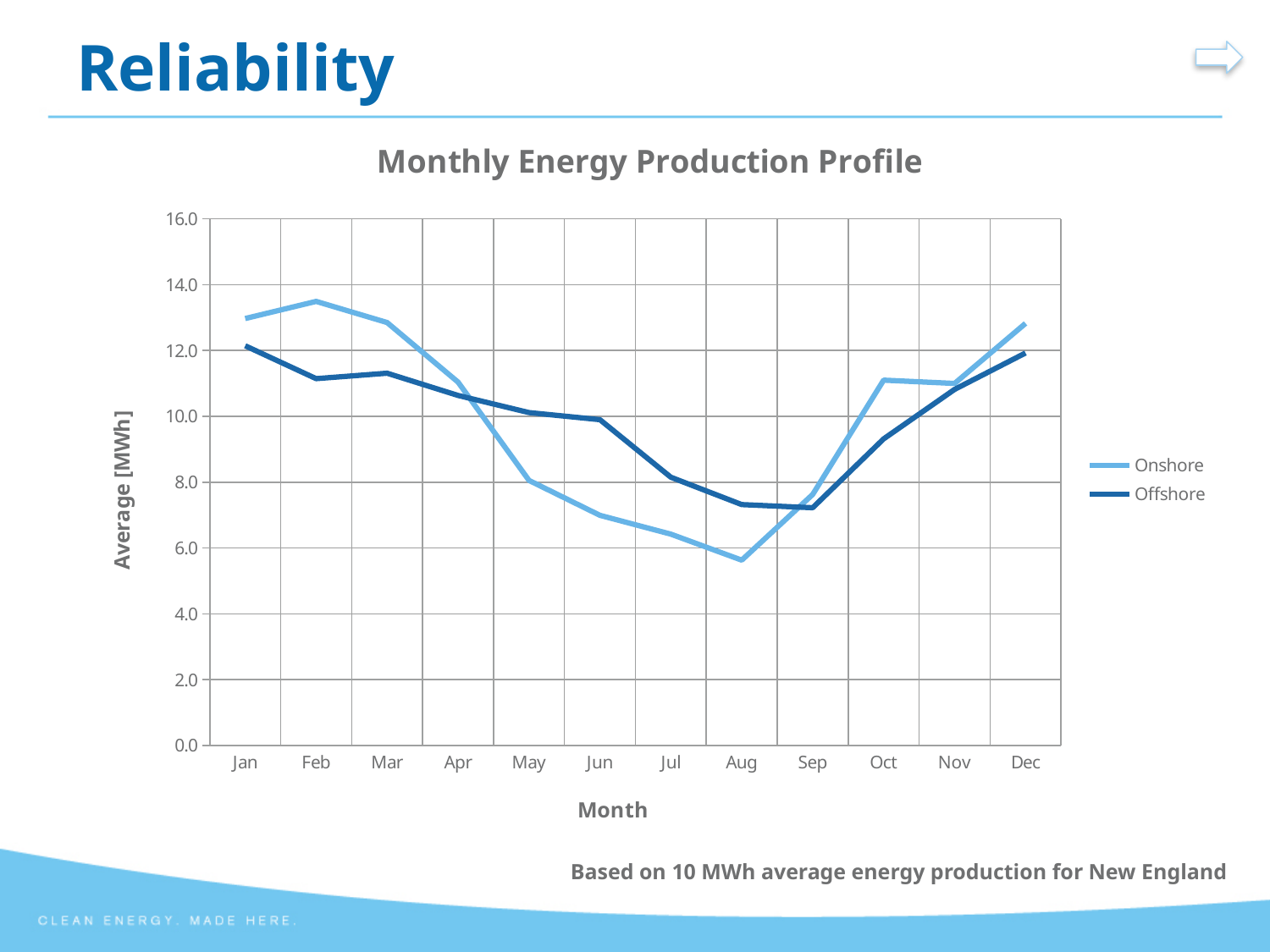
In which month is the Onshore value highest? Feb What is the title of the y axis? Average [MWh] Does the Onshore series rise or fall from Feb to Aug? fall In which month is the Onshore value lowest? Aug In which month is the Offshore value highest? Jan How many months are plotted along the x axis? 12 What kind of chart is shown on the slide? line chart In Jun, which series has the larger value, Onshore or Offshore? Offshore How many series does the legend list? 2 In Jan, which series has the larger value, Onshore or Offshore? Onshore Is the Offshore value for Aug greater or less than 8.0? less Is the Onshore value for Aug greater or less than 6.0? less